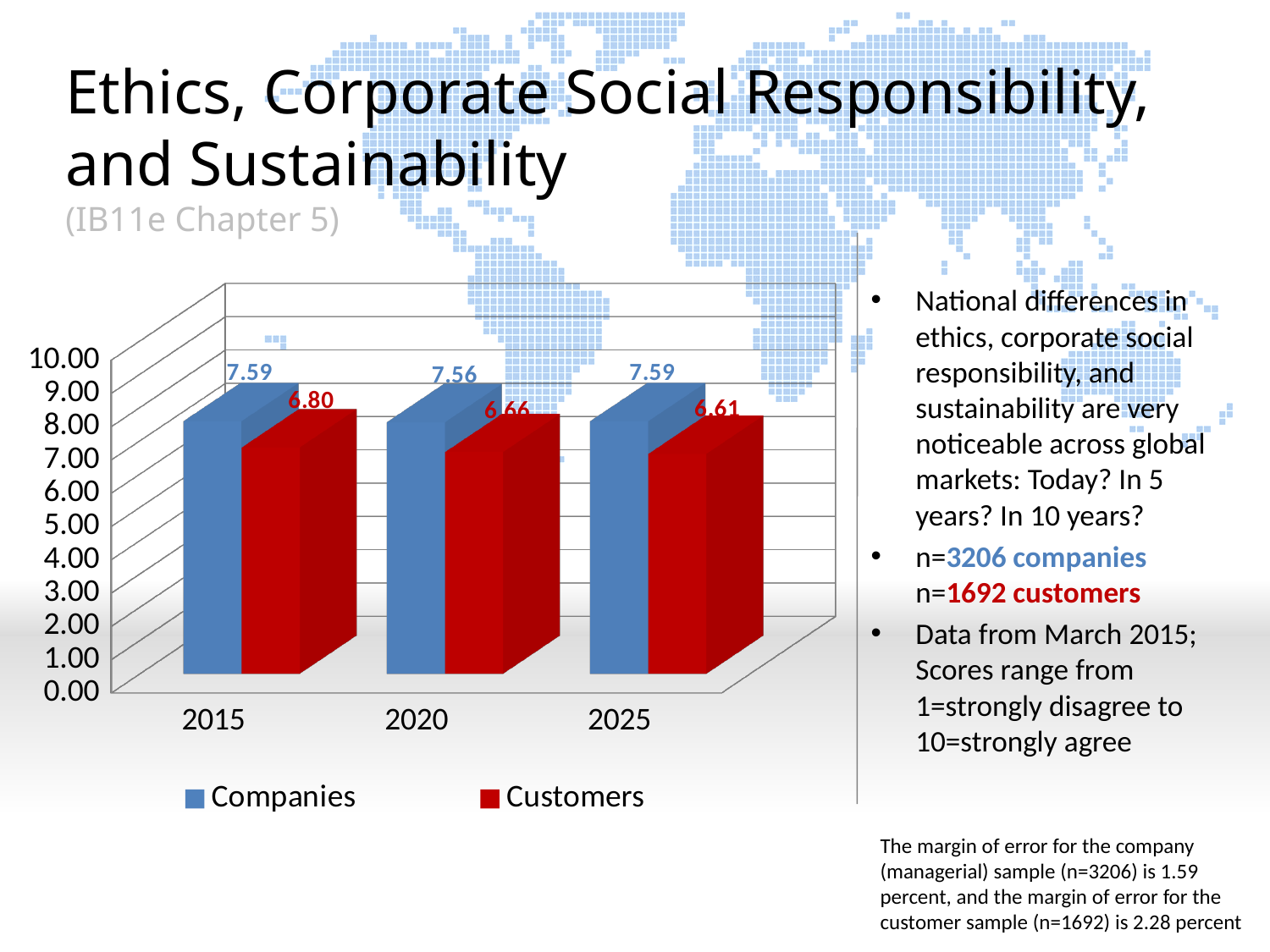
In which year is the Customers value highest? 2015 Do the Customers values rise or fall from 2015 to 2025? Fall What is the difference between the Companies and Customers values in 2015? 0.79 What is the value for Customers in 2025? 6.61 What is the value for Companies in 2015? 7.59 What kind of chart is shown on the slide? Bar chart What is the value for Customers in 2020? 6.66 What is the value for Companies in 2020? 7.56 Which is larger in 2025, the Companies value or the Customers value? Companies How many years are shown on the x axis of the chart? 3 How many series does the chart legend list? 2 In which year is the Customers value lowest? 2025